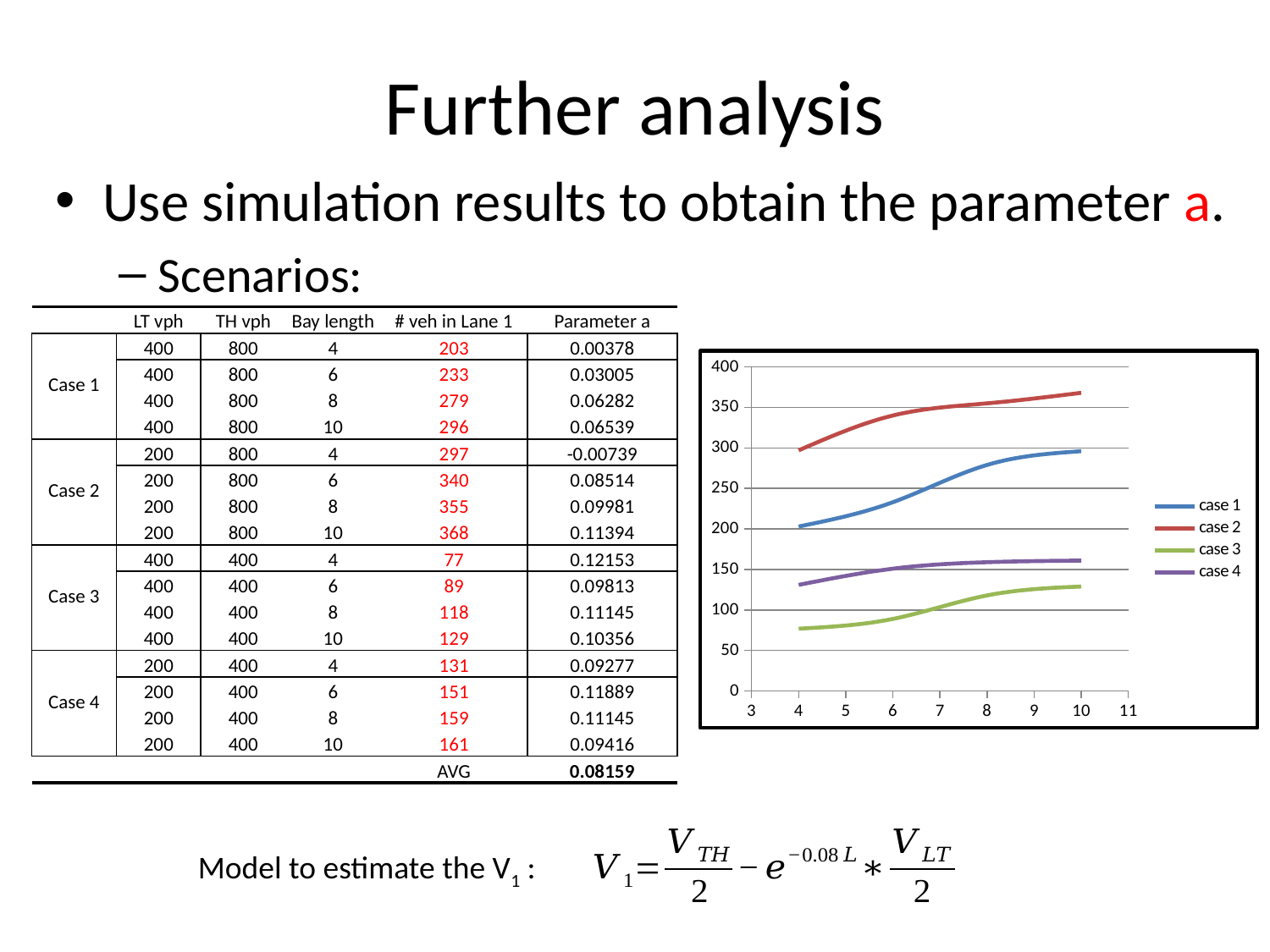
Is the value for case 3 at x = 10 greater or less than 150? less At x = 10, which is larger: case 1 or case 4? case 1 What kind of chart is shown on the slide? line chart Is the value for case 2 at x = 4 greater or less than 250? greater Which series has the highest value at x = 10? case 2 At x = 4, which is larger: case 3 or case 4? case 4 Is the value for case 1 at x = 4 greater or less than 250? less What are the legend entries of the chart? case 1, case 2, case 3, case 4 Which series has the lowest value at x = 4? case 3 How many series does the chart's legend list? 4 Does the case 1 line rise or fall as x increases from 4 to 10? rise